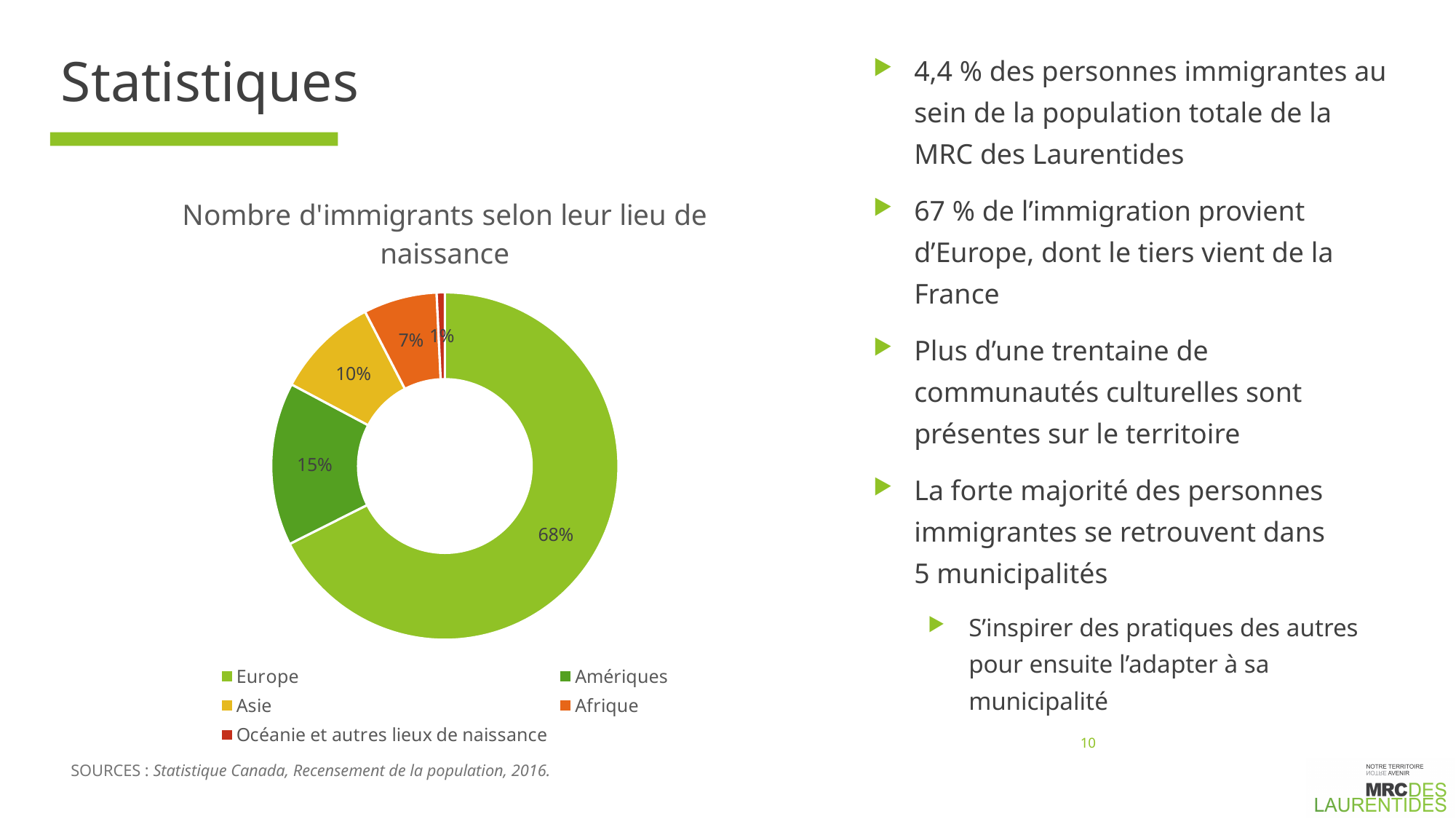
Which place of birth has the largest share of immigrants? Europe How many categories does the chart show? 5 What share is shown for Océanie et autres lieux de naissance? 1% What is the value shown for Asie? 10% What is the value shown for Afrique? 7% What kind of chart is shown on the slide? doughnut (pie) chart What is the title of the chart? Nombre d'immigrants selon leur lieu de naissance What is the difference in percentage points between Europe and Amériques? 53 What percentage of the chart corresponds to Amériques? 15% Which has a larger share, Asie or Afrique? Asie Which place of birth has the smallest share of immigrants? Océanie et autres lieux de naissance What share of immigrants were born in Europe? 68%